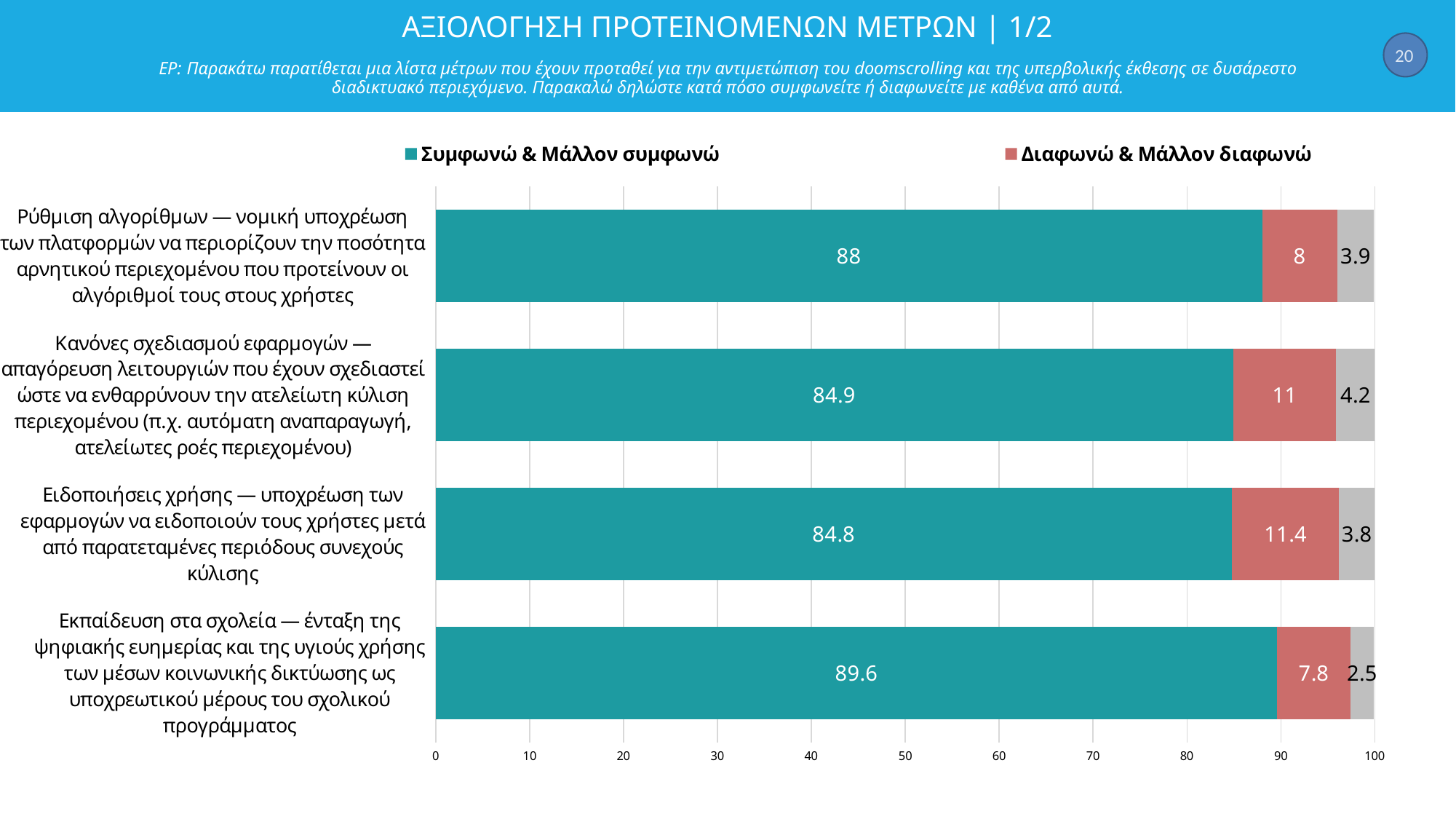
What is the total of the stacked bar for "Ειδοποιήσεις χρήσης" (all three segments)? 100 Which is larger: the "Συμφωνώ & Μάλλον συμφωνώ" value for "Ρύθμιση αλγορίθμων" or for "Κανόνες σχεδιασμού εφαρμογών"? Ρύθμιση αλγορίθμων What is the value of "Διαφωνώ & Μάλλον διαφωνώ" for the measure "Κανόνες σχεδιασμού εφαρμογών"? 11 What is the difference between the "Συμφωνώ & Μάλλον συμφωνώ" values for "Εκπαίδευση στα σχολεία" and "Ρύθμιση αλγορίθμων"? 1.6 What kind of chart is shown on the slide? Stacked bar chart What is the value of "Συμφωνώ & Μάλλον συμφωνώ" for the measure "Ρύθμιση αλγορίθμων"? 88 Is the "Διαφωνώ & Μάλλον διαφωνώ" value for "Κανόνες σχεδιασμού εφαρμογών" greater or less than 20? less Which measure has the highest value for "Συμφωνώ & Μάλλον συμφωνώ"? Εκπαίδευση στα σχολεία How many measures (categories) are shown in the chart? 4 How many series does the legend list? 2 What is the value of "Διαφωνώ & Μάλλον διαφωνώ" for the measure "Ειδοποιήσεις χρήσης"? 11.4 What is the value of "Συμφωνώ & Μάλλον συμφωνώ" for the measure "Εκπαίδευση στα σχολεία"? 89.6